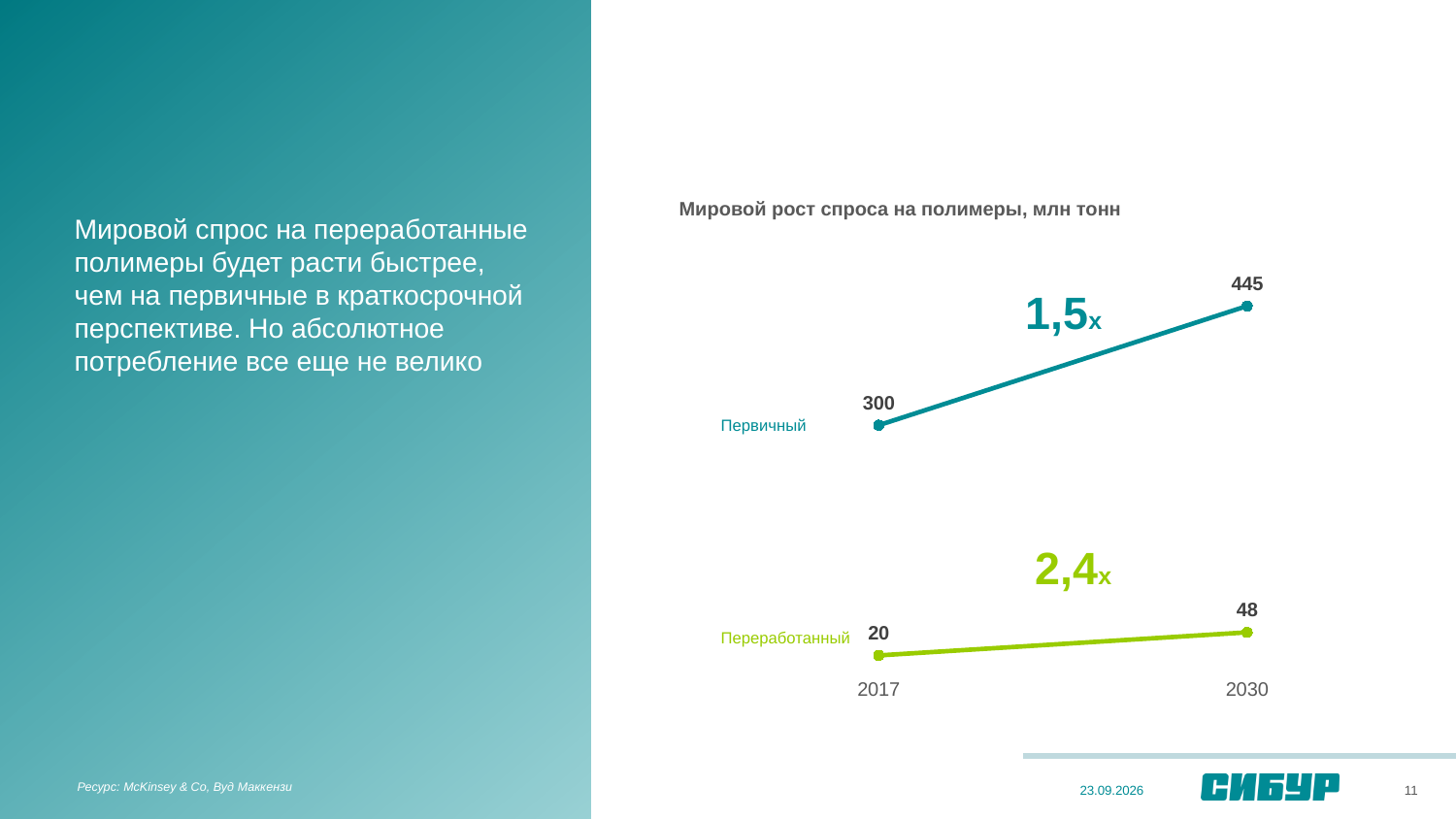
Which series has the higher value in 2030, Первичный or Переработанный? Первичный What is the value for Переработанный in 2030? 48 What growth multiplier is shown for the Переработанный series? 2,4x By how much does the value for Первичный increase from 2017 to 2030? 145 How many years are shown on the x axis of the chart? 2 By how much does the value for Переработанный increase from 2017 to 2030? 28 What is the value for Переработанный in 2017? 20 What is the value for Первичный in 2030? 445 Does the value for Переработанный rise or fall from 2017 to 2030? rise How many series are plotted on the chart? 2 What kind of chart is shown on the slide? line chart What is the value for Первичный in 2017? 300